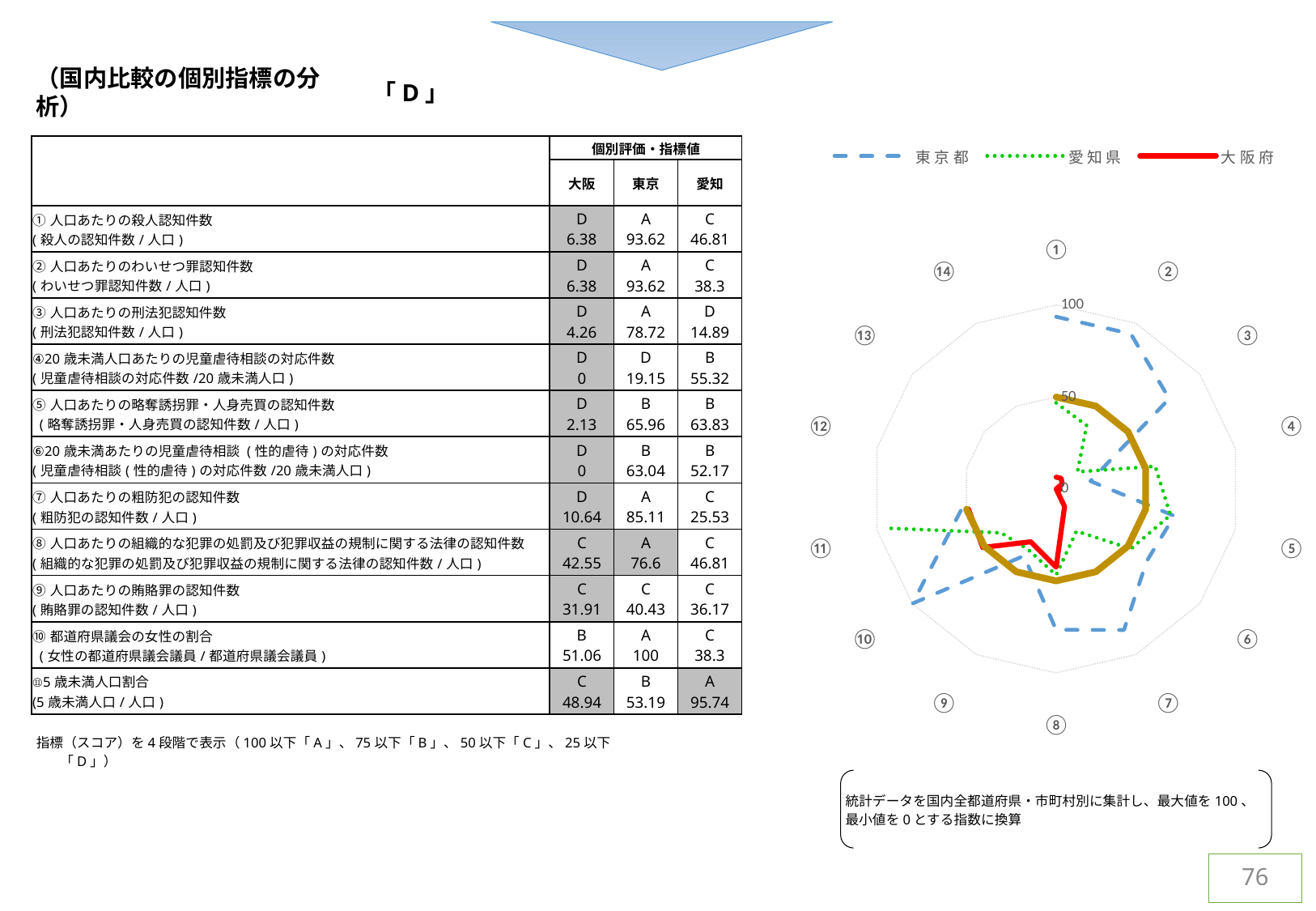
How many numbered axes (categories) does the radar chart have? 14 On the radar chart, which series reaches the highest value on axis ①? 東京都 What is the highest value shown on the radar chart's scale? 100 On the radar chart, is the value of 東京都 on axis ① greater or less than 50? greater How many series does the legend of the radar chart list? 3 On the radar chart, which series has the larger value on axis ①, 東京都 or 大阪府? 東京都 On the radar chart, which series has the larger value on axis ⑪, 愛知県 or 大阪府? 愛知県 Which three series are listed in the legend of the radar chart? 東京都, 愛知県, 大阪府 On the radar chart, is the value of 東京都 on axis ⑧ greater or less than 50? greater On the radar chart, is the value of 愛知県 on axis ⑪ greater or less than 50? greater What kind of chart is shown on the right side of the slide? radar chart